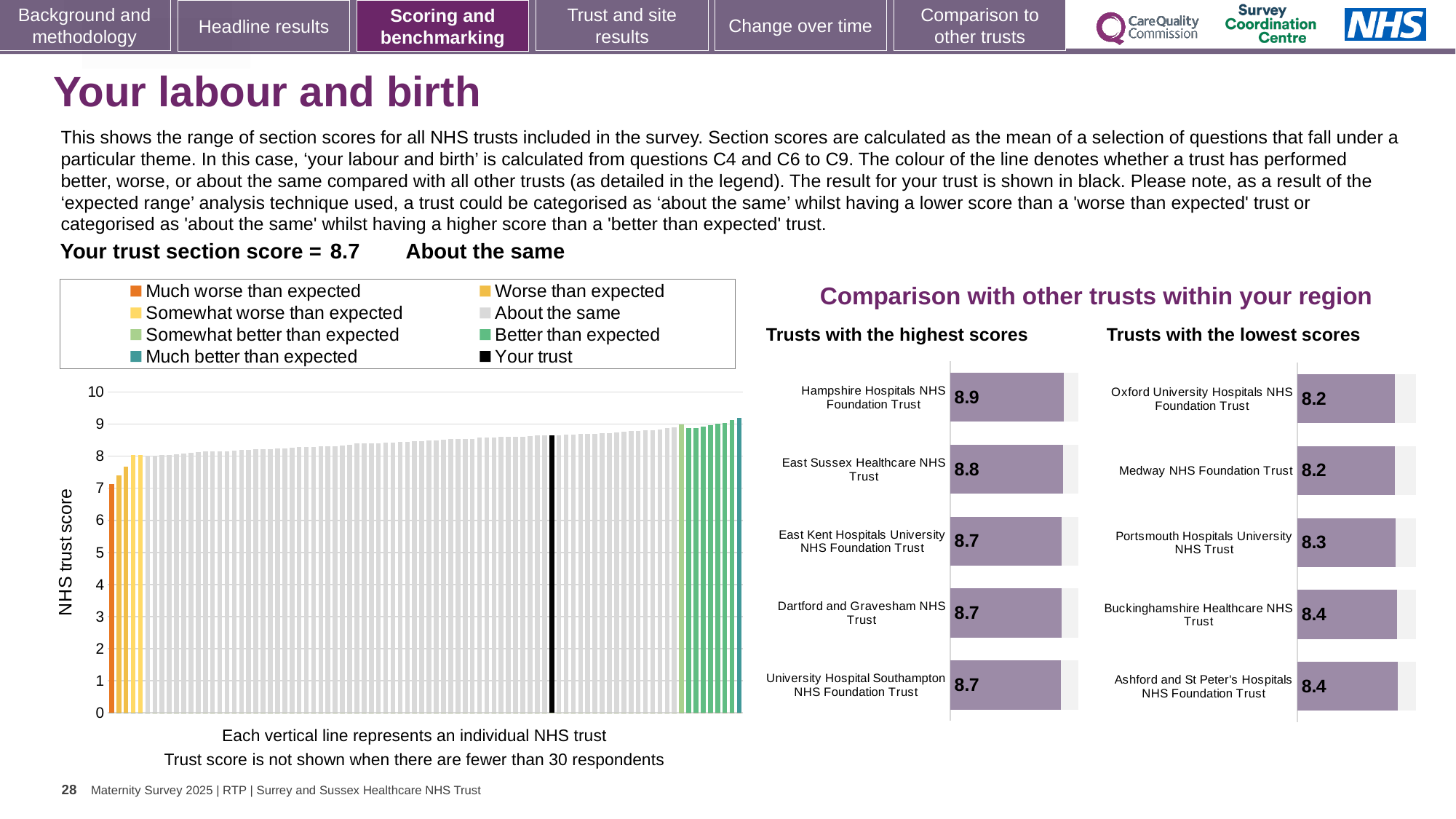
What kind of chart is the large chart on the left showing all NHS trusts? Bar chart In the large chart on the left showing all NHS trusts, do the bar values rise or fall from left to right? Rise In the 'Trusts with the lowest scores' chart, which has the larger score: Portsmouth Hospitals University NHS Trust or Buckinghamshire Healthcare NHS Trust? Buckinghamshire Healthcare NHS Trust In the 'Trusts with the highest scores' chart, which trust has the highest score? Hampshire Hospitals NHS Foundation Trust In the 'Trusts with the highest scores' chart, what is the score for East Sussex Healthcare NHS Trust? 8.8 In the 'Trusts with the highest scores' chart, what is the score for Hampshire Hospitals NHS Foundation Trust? 8.9 In the 'Trusts with the highest scores' chart, what is the difference between the scores of Hampshire Hospitals NHS Foundation Trust and East Sussex Healthcare NHS Trust? 0.1 How many trusts are shown in the 'Trusts with the lowest scores' chart? 5 In the 'Trusts with the lowest scores' chart, what is the difference between the scores of Ashford and St Peter's Hospitals NHS Foundation Trust and Oxford University Hospitals NHS Foundation Trust? 0.2 In the 'Trusts with the lowest scores' chart, what is the score for Portsmouth Hospitals University NHS Trust? 8.3 In the large chart on the left showing all NHS trusts, how many entries does the legend list? 8 In the 'Trusts with the lowest scores' chart, what is the score for Oxford University Hospitals NHS Foundation Trust? 8.2